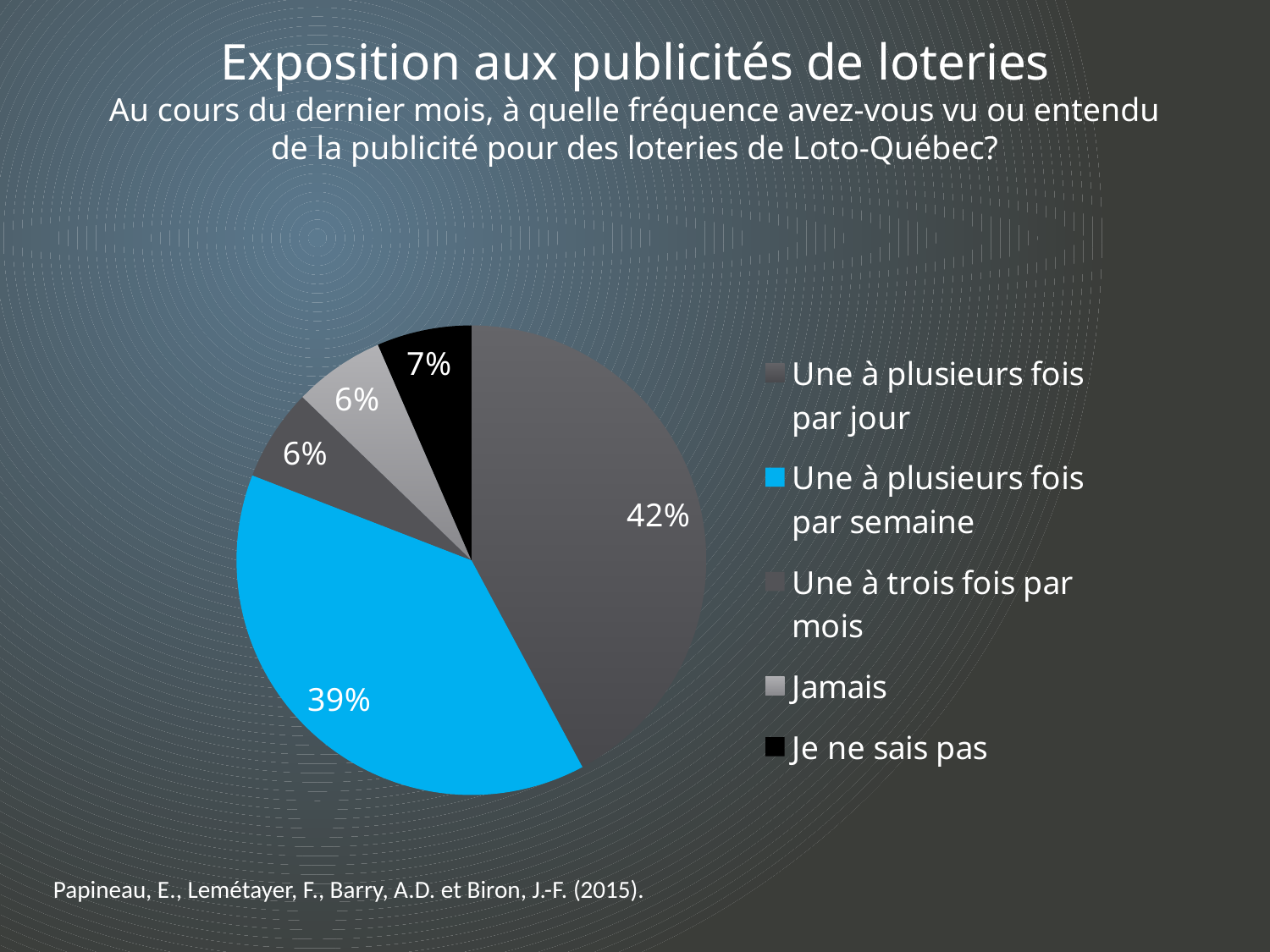
How many categories does the legend list? 5 Which is larger: the share for "Je ne sais pas" or the share for "Jamais"? Je ne sais pas What percentage of respondents answered "Jamais"? 6% What percentage of respondents answered "Une à plusieurs fois par jour"? 42% What is the combined share of "Une à plusieurs fois par jour" and "Une à plusieurs fois par semaine"? 81% What is the difference in percentage points between "Une à plusieurs fois par jour" and "Une à plusieurs fois par semaine"? 3 What type of chart is shown on the slide? pie chart What percentage of respondents answered "Je ne sais pas"? 7% Which response category has the largest share of the pie? Une à plusieurs fois par jour Which legend entry is shown in blue? Une à plusieurs fois par semaine What percentage of respondents answered "Une à plusieurs fois par semaine"? 39% What percentage of respondents answered "Une à trois fois par mois"? 6%